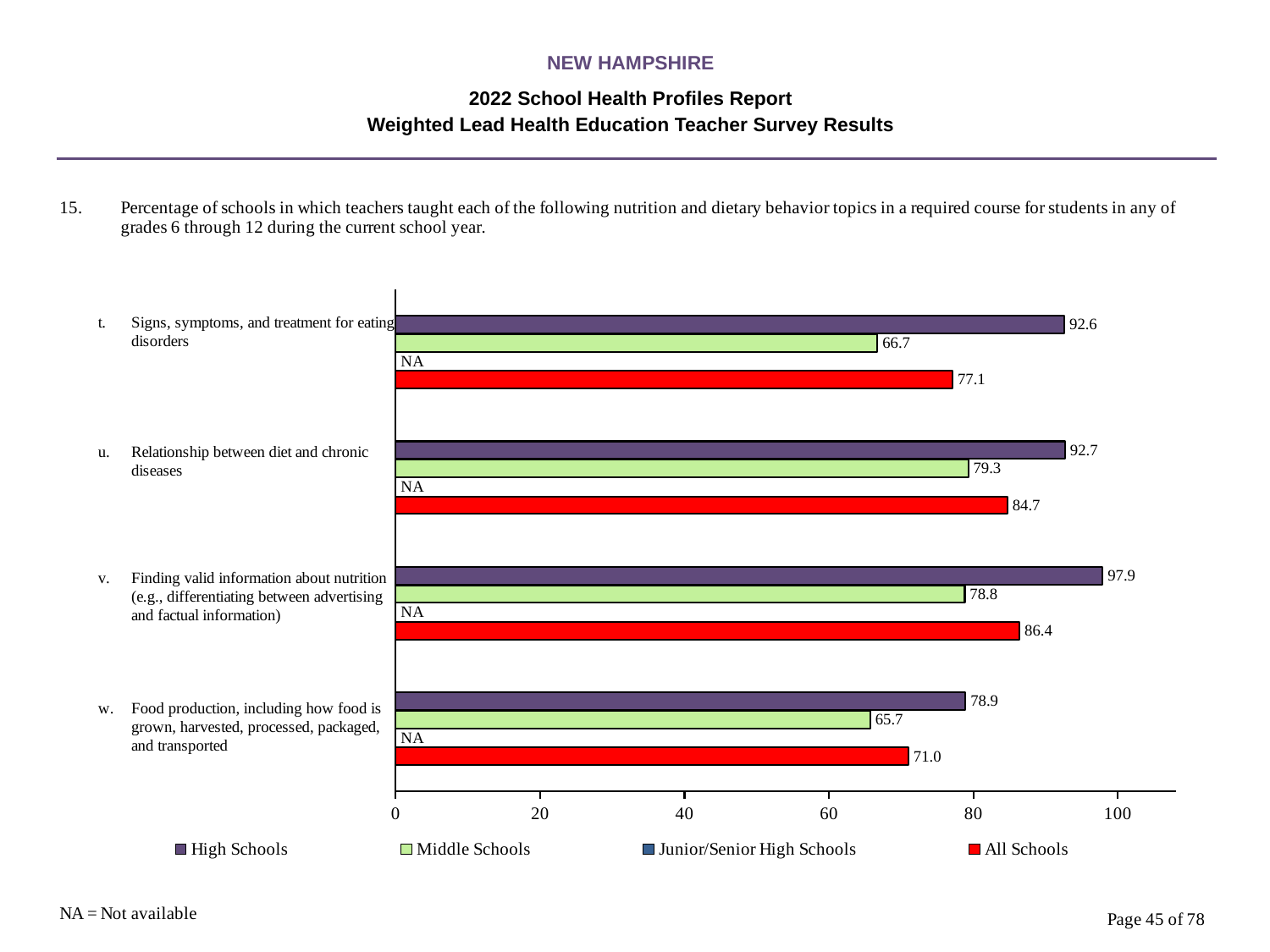
Which is larger: the Middle Schools value for "Relationship between diet and chronic diseases" or the Middle Schools value for "Finding valid information about nutrition"? Relationship between diet and chronic diseases How many series does the legend list? 4 What kind of chart is shown on the slide? bar chart What is the High Schools value for "Finding valid information about nutrition"? 97.9 Is the All Schools value for "Food production" greater or less than 80? less Which topic has the highest High Schools value? Finding valid information about nutrition What is the Middle Schools value for "Food production, including how food is grown, harvested, processed, packaged, and transported"? 65.7 What is the difference between the High Schools and Middle Schools values for "Signs, symptoms, and treatment for eating disorders"? 25.9 What value is shown for Junior/Senior High Schools for "Signs, symptoms, and treatment for eating disorders"? NA What is the All Schools value for "Relationship between diet and chronic diseases"? 84.7 How many topics (categories) are shown on the chart? 4 Which topic has the lowest All Schools value? Food production, including how food is grown, harvested, processed, packaged, and transported